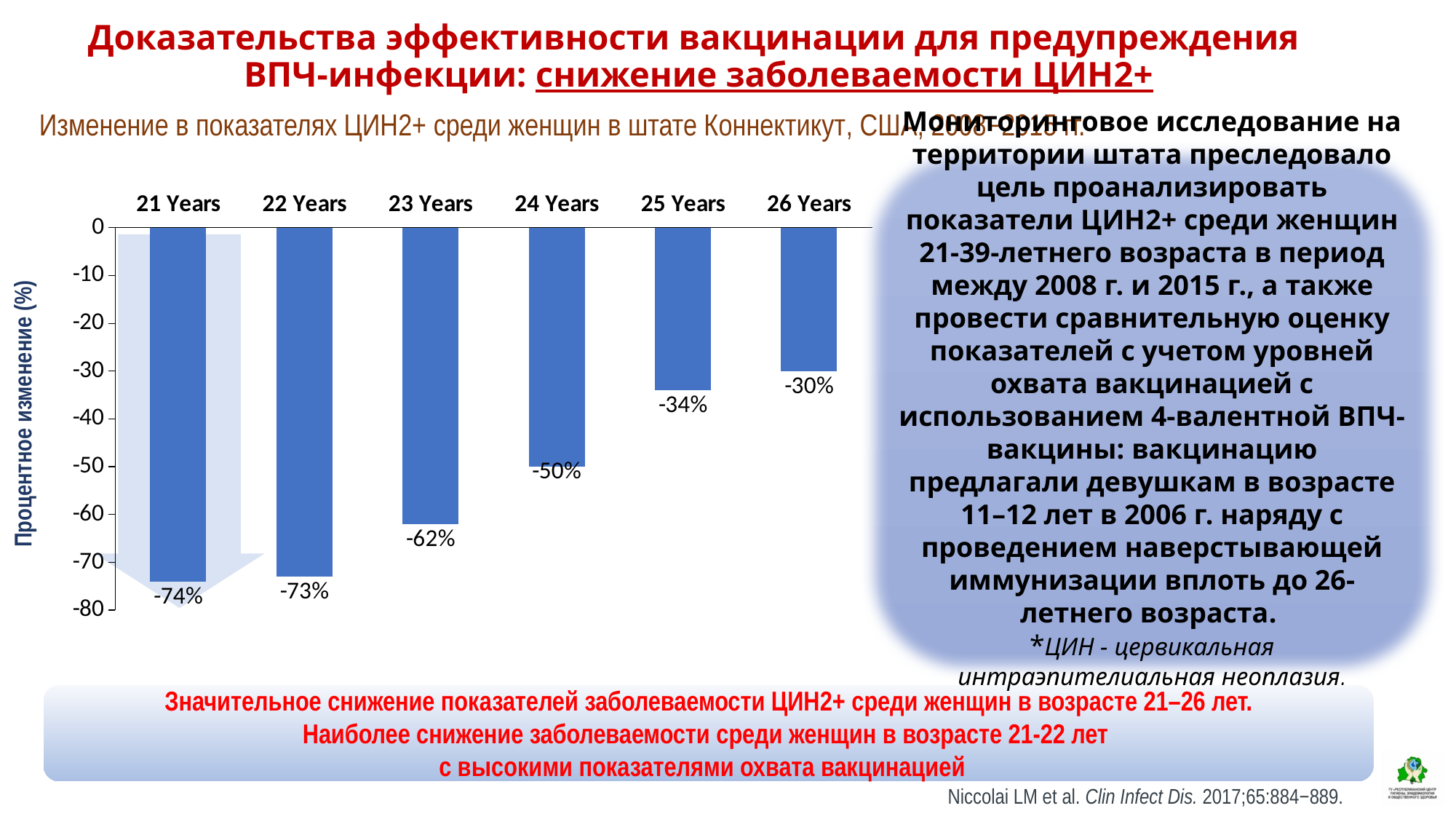
How does the size of the percentage decrease change as age increases from 21 Years to 26 Years? It gets smaller What is the percentage change in CIN2+ rates for women aged 21 Years? -74% What is the percentage change shown for 23 Years? -62% What is the label of the vertical axis of the chart? Процентное изменение (%) By how many percentage points does the decrease for 24 Years exceed the decrease for 25 Years? 16 What value is labelled on the bar for 26 Years? -30% Which age group shows the largest percentage decrease in CIN2+ rates? 21 Years What type of chart is used to show the change in CIN2+ rates? Bar chart Which age group has a larger percentage decrease, 22 Years or 25 Years? 22 Years What is the percentage change shown for the 24 Years category? -50% Which age group shows the smallest percentage decrease in CIN2+ rates? 26 Years How many age categories are shown on the chart? 6